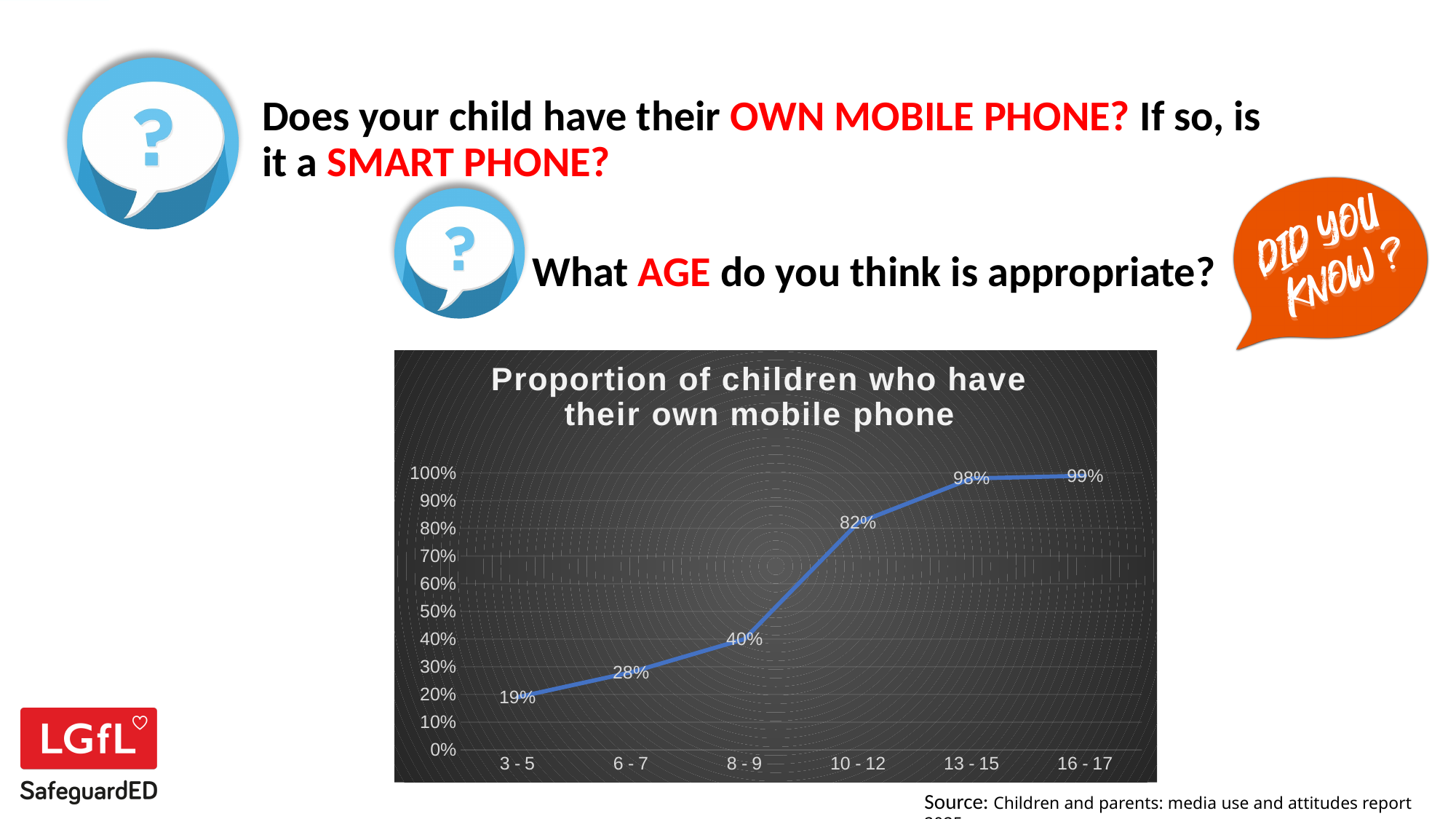
How many age groups are shown on the x axis? 6 Which age group has the highest proportion of children with their own mobile phone? 16 - 17 Which age group has the lowest proportion of children with their own mobile phone? 3 - 5 What is the difference between the values for the 10 - 12 and 8 - 9 age groups? 42% What kind of chart is shown on the slide? Line chart What is the difference between the values for the 6 - 7 and 3 - 5 age groups? 9% What is the value for the 10 - 12 age group? 82% What is the value for the 8 - 9 age group? 40% What is the proportion of children aged 3 - 5 who have their own mobile phone? 19% Do the values rise or fall as age increases along the x axis? Rise Which is larger, the value for 6 - 7 or the value for 8 - 9? 8 - 9 Is the value for the 10 - 12 age group greater or less than 70%? greater